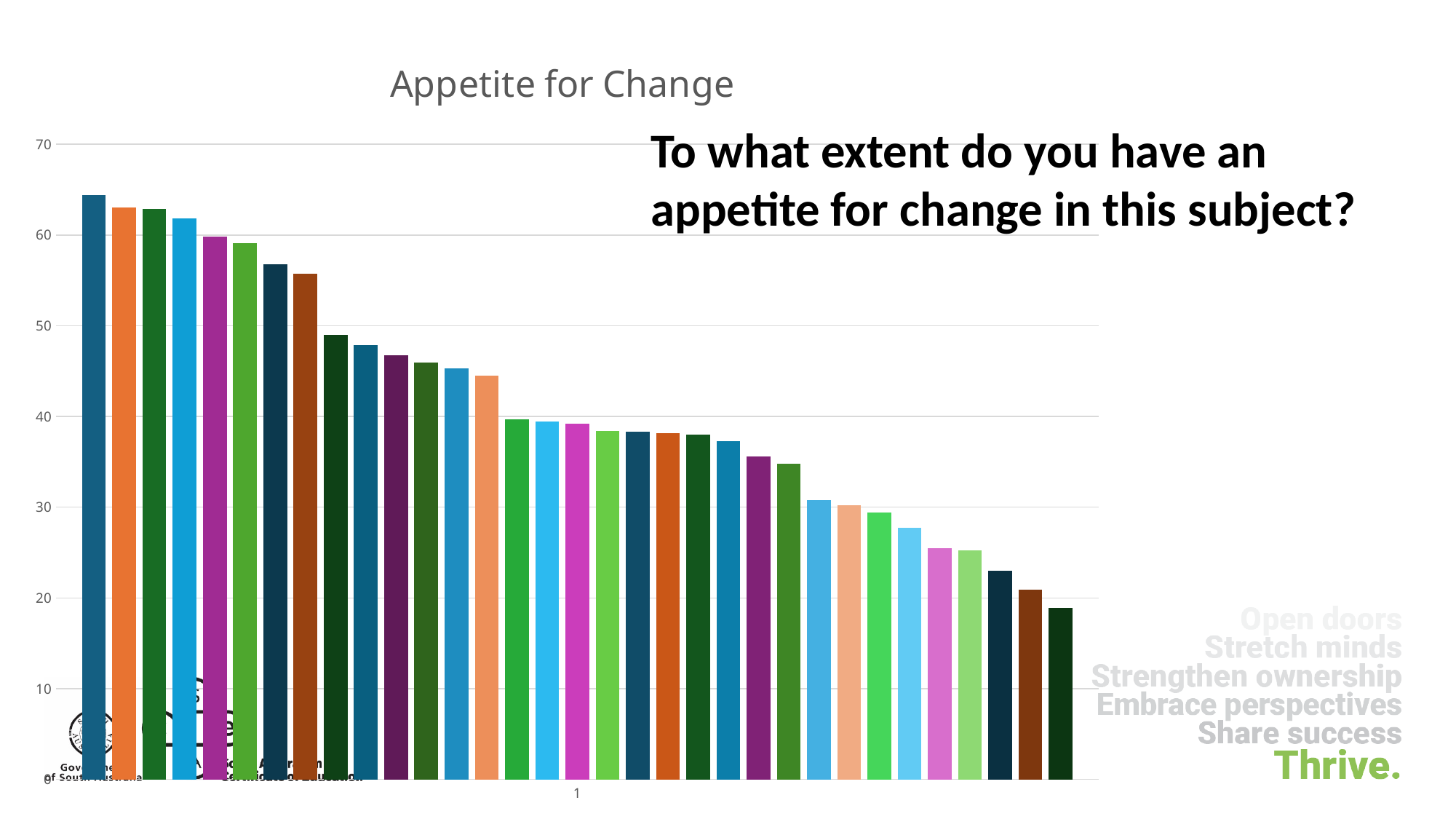
Is the value of the tallest bar greater or less than 70? less Is the value of the rightmost bar greater or less than 20? less Which bar is the shortest in the chart? The rightmost bar Which is larger, the leftmost bar or the rightmost bar? The leftmost bar What label is shown on the x axis beneath the bars? 1 Is the value of the eighth bar from the left (the brown bar) greater or less than 50? greater Do the bar values rise or fall from left to right across the chart? Fall What is the title of the chart? Appetite for Change Which bar is the tallest in the chart? The leftmost bar What kind of chart is shown on the slide? Bar chart How many bars are plotted in the chart? 33